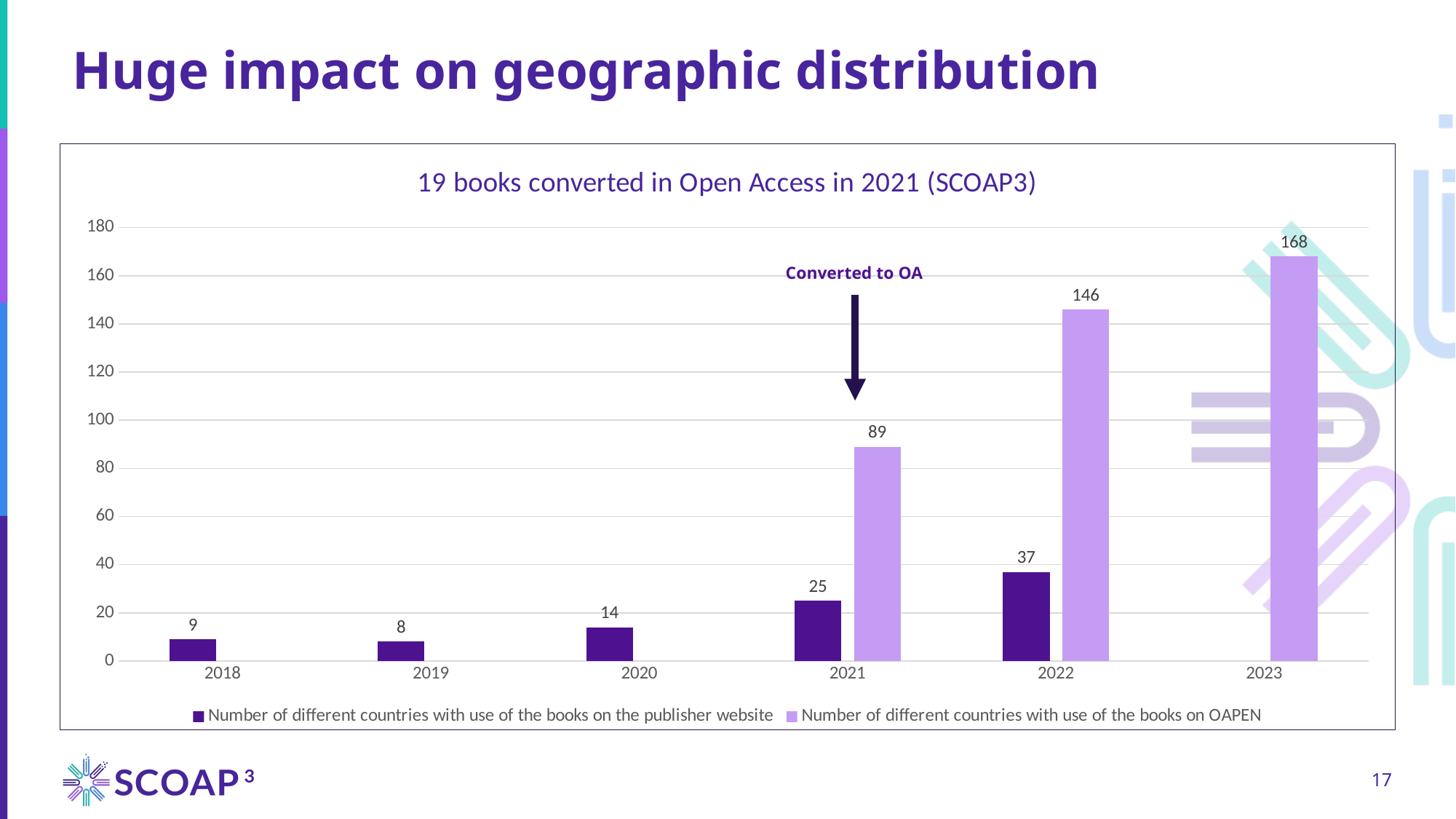
What is the number of different countries with use of the books on OAPEN in 2022? 146 How many series does the legend list? 2 What is the title of the chart? 19 books converted in Open Access in 2021 (SCOAP3) Which is larger in 2021: the publisher website value or the OAPEN value? OAPEN What is the number of different countries with use of the books on OAPEN in 2023? 168 What kind of chart is shown on the slide? Bar chart What is the difference between the OAPEN value and the publisher website value in 2022? 109 How many years are shown on the x axis? 6 Which year has the lowest number of different countries with use of the books on the publisher website? 2019 Is the OAPEN value for 2023 greater or less than 160? greater Which year has the highest number of different countries with use of the books on OAPEN? 2023 What is the number of different countries with use of the books on the publisher website in 2021? 25